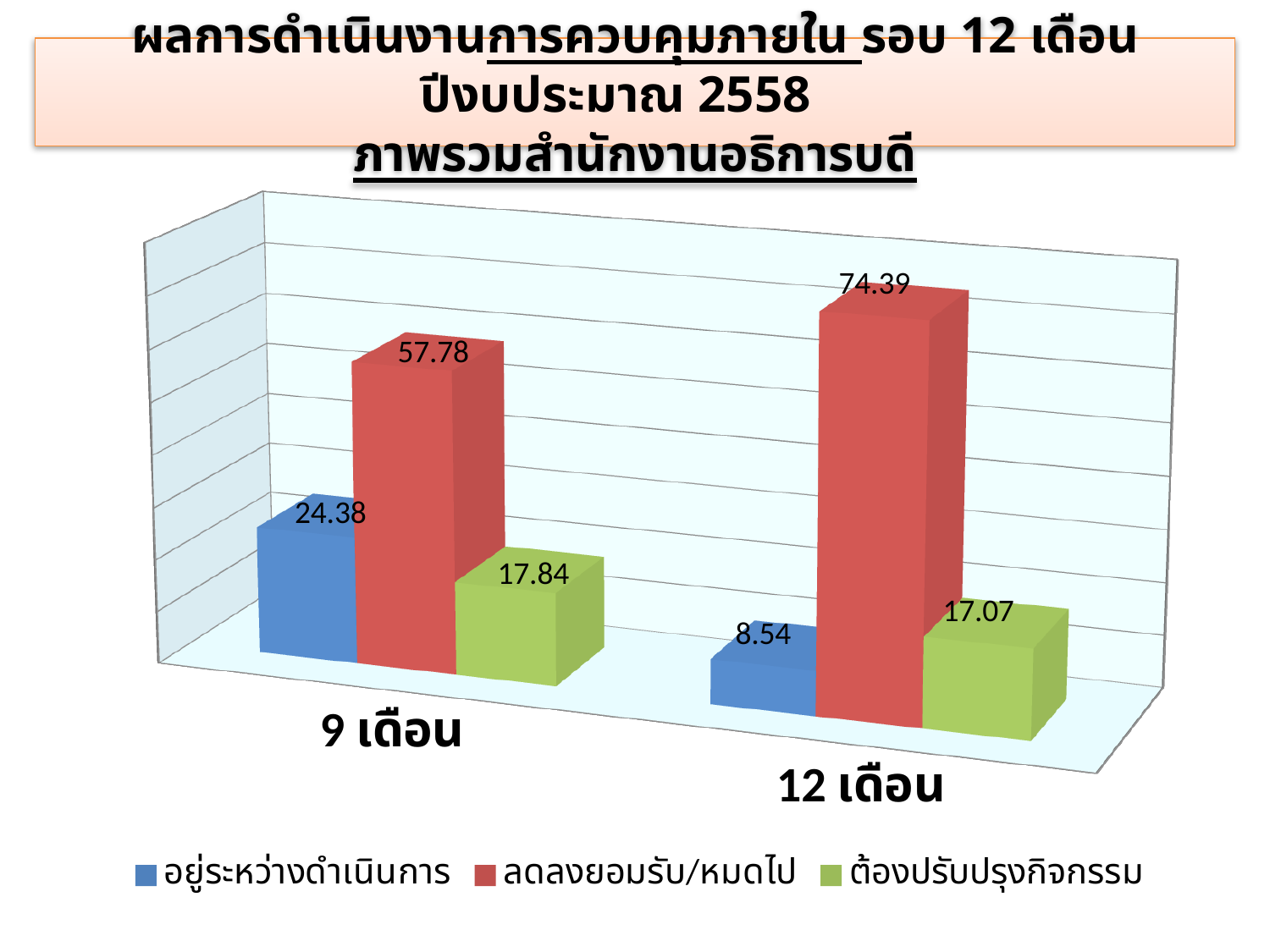
What is the value for ต้องปรับปรุงกิจกรรม at 12 เดือน? 17.07 What is the value for ลดลงยอมรับ/หมดไป at 12 เดือน? 74.39 Which is larger: อยู่ระหว่างดำเนินการ at 9 เดือน or ต้องปรับปรุงกิจกรรม at 9 เดือน? อยู่ระหว่างดำเนินการ at 9 เดือน What is the value for ลดลงยอมรับ/หมดไป at 9 เดือน? 57.78 Which series has the lowest value at 12 เดือน? อยู่ระหว่างดำเนินการ What is the difference between the อยู่ระหว่างดำเนินการ values at 9 เดือน and 12 เดือน? 15.84 What is the difference between the ลดลงยอมรับ/หมดไป values at 12 เดือน and 9 เดือน? 16.61 How many series does the legend list? 3 What kind of chart is shown on the slide? Bar chart How many categories are shown on the x axis? 2 Which series has the highest value at 12 เดือน? ลดลงยอมรับ/หมดไป What is the value for อยู่ระหว่างดำเนินการ at 9 เดือน? 24.38